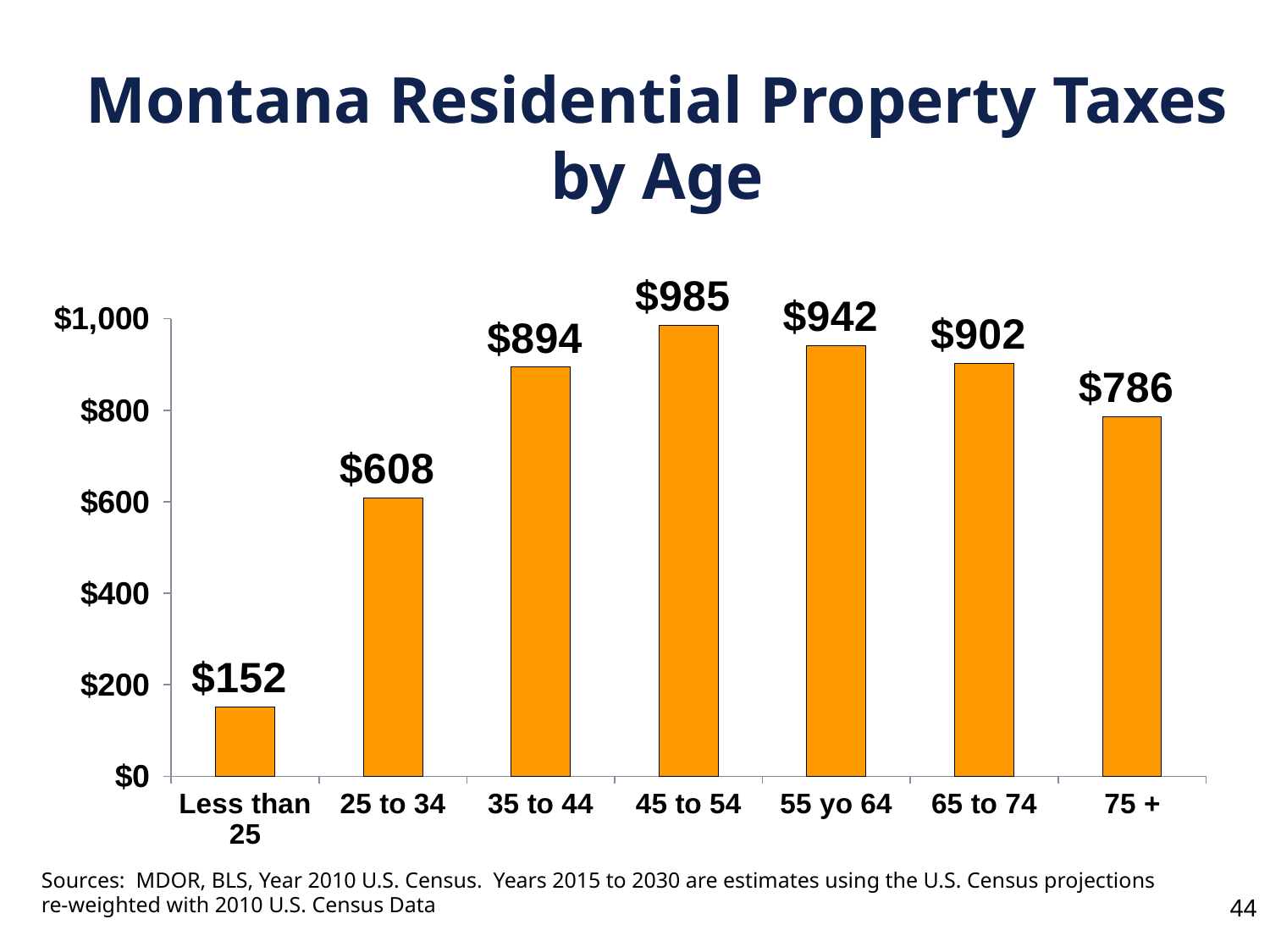
What is the difference between the values for 25 to 34 and Less than 25? $456 What is the value for the 45 to 54 age group? $985 What kind of chart is shown on the slide? bar chart How many age groups are shown on the chart? 7 What is the value for the Less than 25 age group? $152 Which age group has the lowest value? Less than 25 What is the value for the 75 + age group? $786 What is the difference between the values for 45 to 54 and 75 +? $199 Which is larger, the value for 35 to 44 or the value for 65 to 74? 65 to 74 Is the value for 25 to 34 greater or less than $800? less What is the title of the chart? Montana Residential Property Taxes by Age Which age group has the highest value? 45 to 54